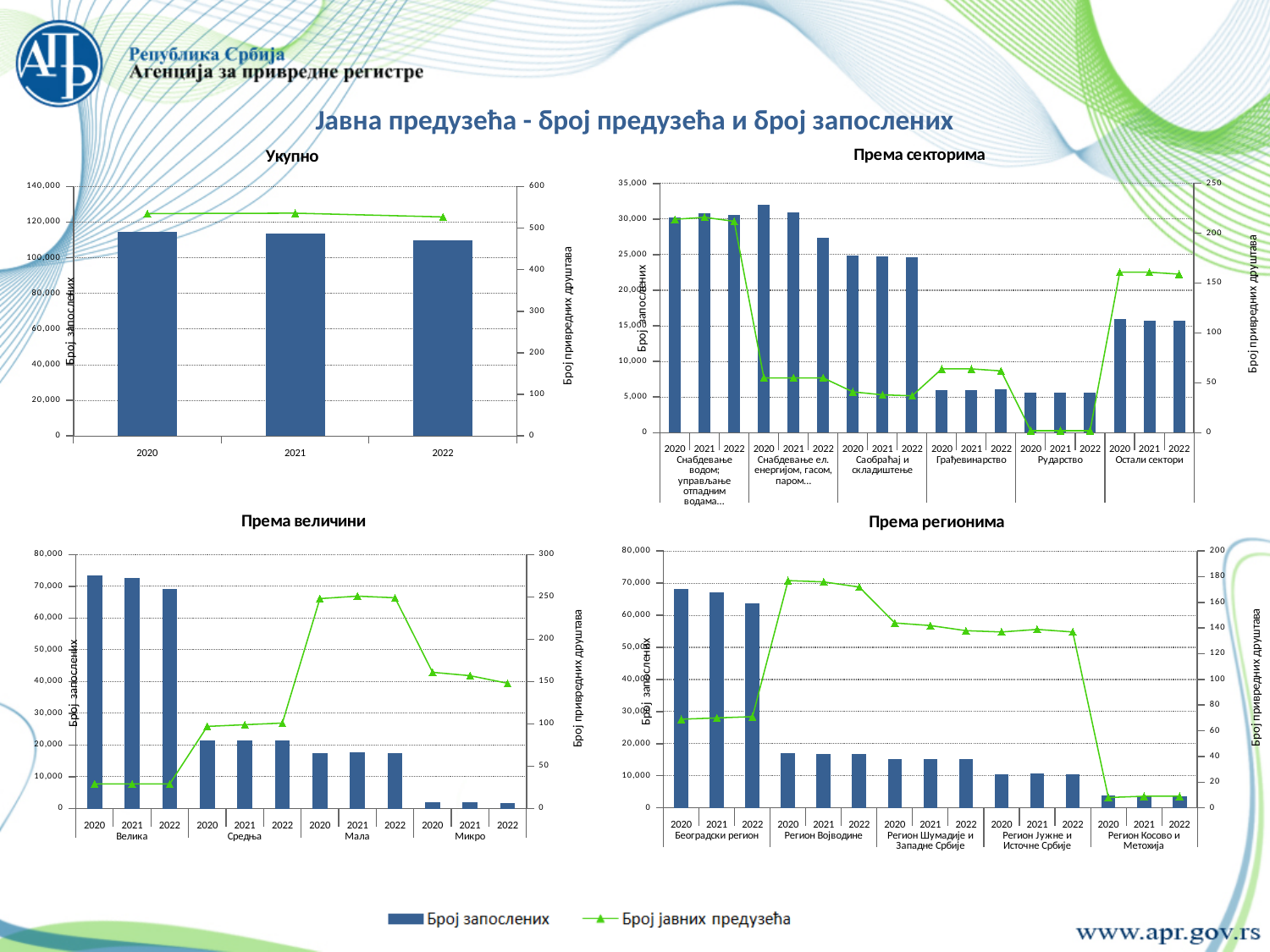
On the 'Према регионима' chart, is the bar for Регион Косово и Метохија in 2020 greater or less than 10,000? less On the 'Према регионима' chart, which bar is larger: Београдски регион 2020 or Регион Војводине 2020? Београдски регион 2020 On the 'Према величини' chart, is the line value for Мала in 2021 greater or less than 200? greater On the 'Укупно' chart, do the bars for number of employees rise or fall from 2020 to 2022? fall On the 'Укупно' chart, how many years are shown on the x axis? 3 On the 'Према секторима' chart, which sector and year has the tallest bar? Снабдевање ел. енергијом, гасом, паром… 2020 On the 'Према секторима' chart, is the bar for Рударство in 2020 greater or less than 10,000? less On the 'Према величини' chart, which size category and year has the tallest bar? Велика 2020 How many series does the legend at the bottom of the slide list? 2